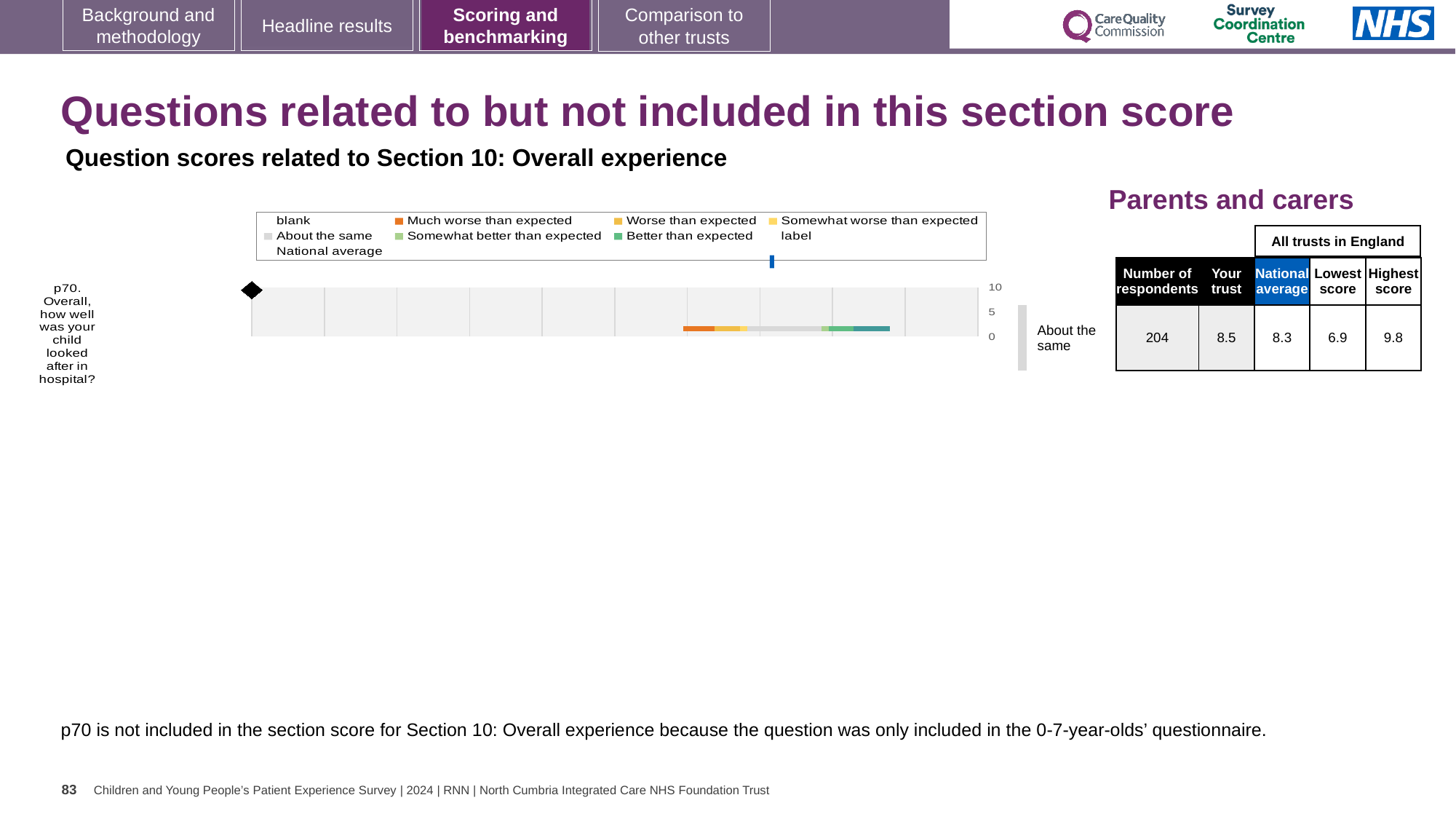
Which is larger for p70, the trust's score or the national average? Your trust How many questions are plotted in the chart? 1 What is the difference between the trust's score and the national average for p70? 0.2 What kind of chart is shown on the slide? bar chart What is the difference between the highest and lowest scores for p70 across all trusts in England? 2.9 Which question is plotted in the chart? p70. Overall, how well was your child looked after in hospital? What is the lowest score among all trusts in England for p70? 6.9 What is the highest score among all trusts in England for p70? 9.8 What benchmark category is shown to the right of the bar for p70? About the same How many respondents answered p70? 204 What is the national average score for p70? 8.3 What is the 'Your trust' score for p70 in the table next to the chart? 8.5